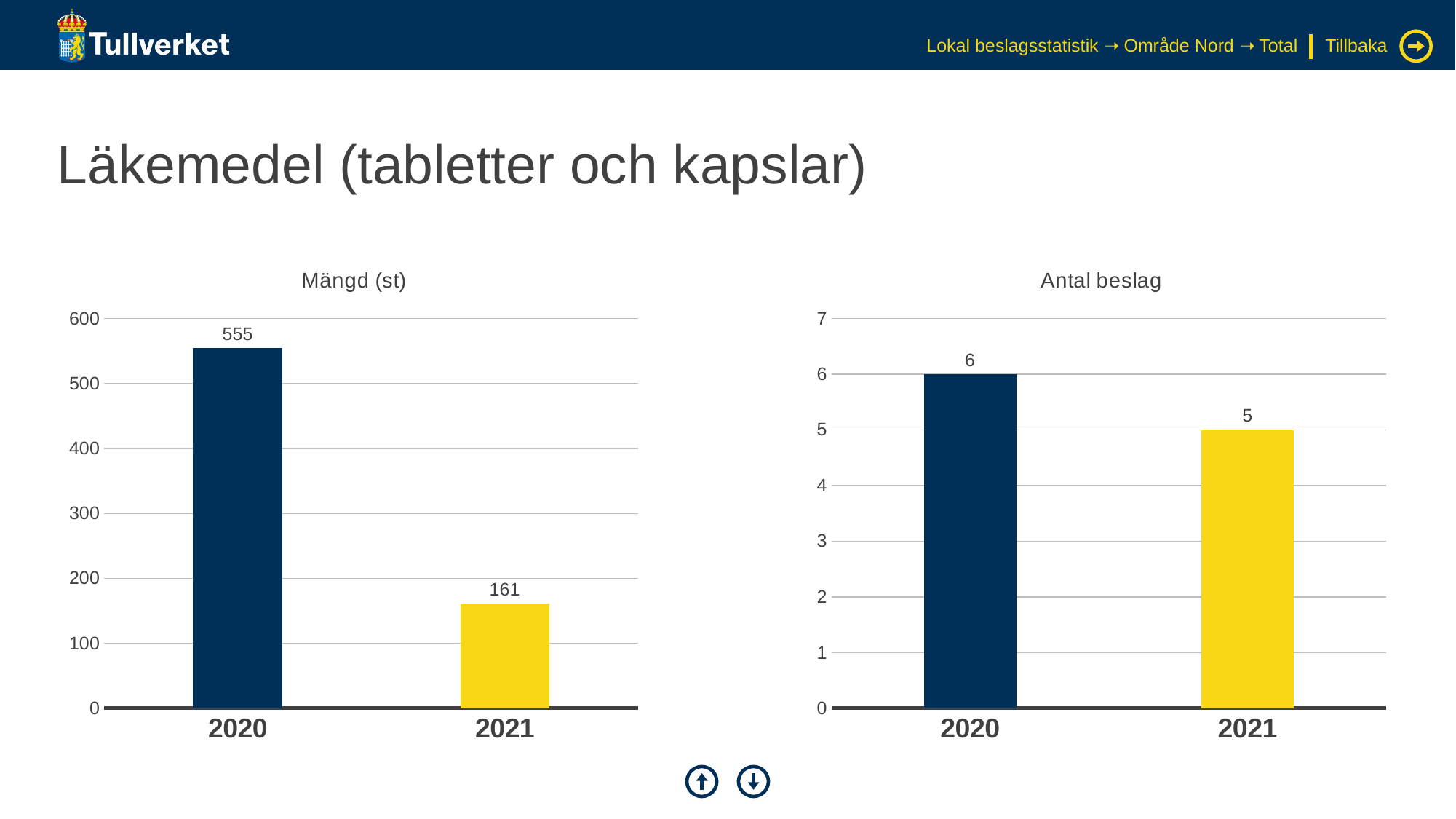
In the 'Antal beslag' chart, what is the difference between the 2020 and 2021 values? 1 In the 'Mängd (st)' chart, what is the value for 2020? 555 In the 'Mängd (st)' chart, what is the difference between the 2020 and 2021 values? 394 In the 'Antal beslag' chart, which is larger, the value for 2020 or 2021? 2020 In the 'Antal beslag' chart, what is the value for 2021? 5 What kind of chart is the 'Antal beslag' chart? Bar chart In the 'Mängd (st)' chart, what is the value for 2021? 161 In the 'Mängd (st)' chart, do the values rise or fall from 2020 to 2021? Fall In the 'Antal beslag' chart, what is the value for 2020? 6 In the 'Mängd (st)' chart, which year has the highest value? 2020 In the 'Mängd (st)' chart, how many bars are shown? 2 In the 'Antal beslag' chart, which year has the lowest value? 2021